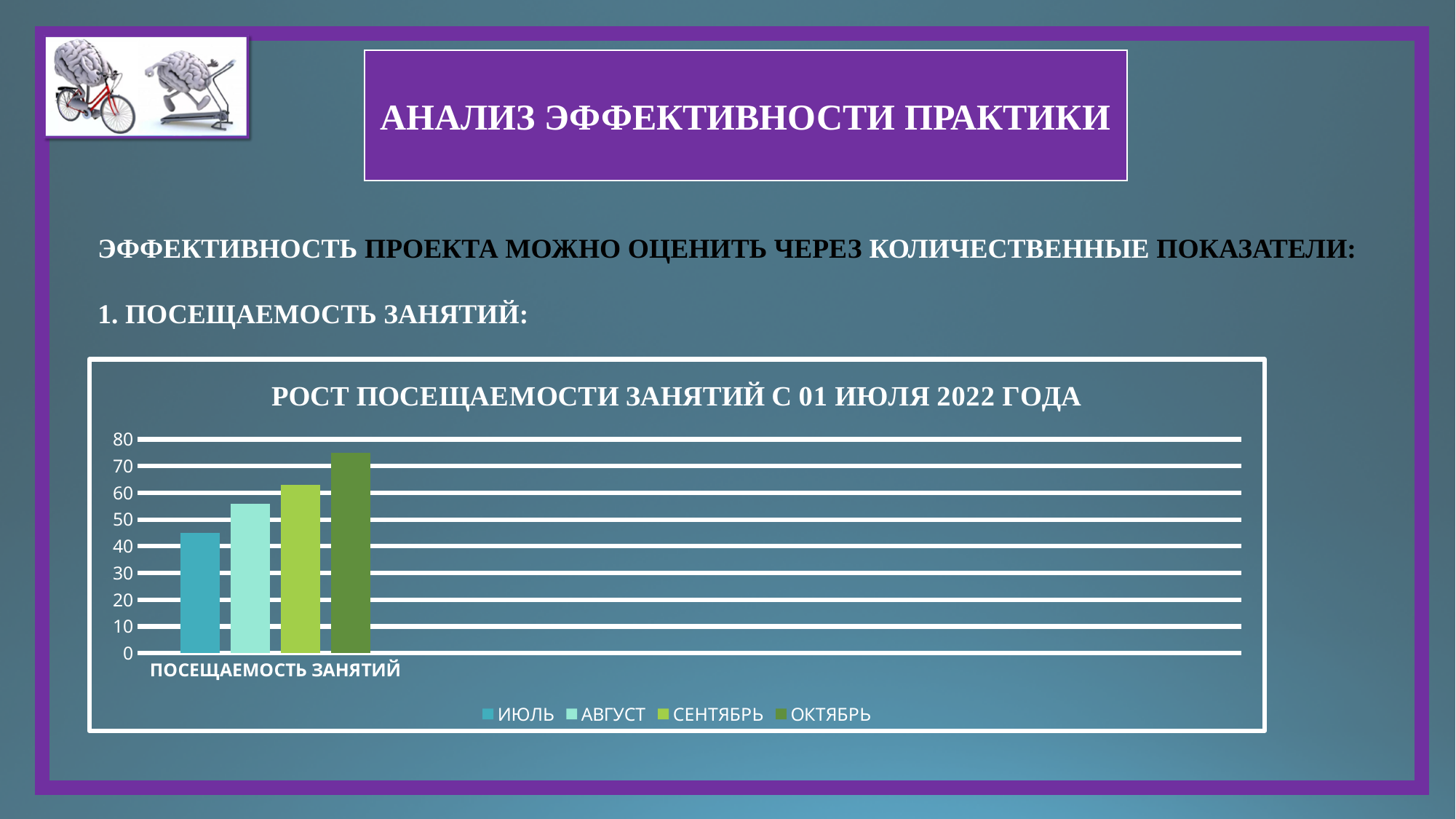
Is the value for АВГУСТ greater or less than 50? greater Is the value for СЕНТЯБРЬ greater or less than 70? less What kind of chart is shown on the slide? bar chart How many series does the legend list? 4 Is the value for ОКТЯБРЬ greater or less than 70? greater How many categories are shown on the x axis? 1 Do the bars rise or fall from ИЮЛЬ to ОКТЯБРЬ? rise Which is larger, the bar for АВГУСТ or the bar for СЕНТЯБРЬ? СЕНТЯБРЬ Which month has the lowest attendance bar? ИЮЛЬ Which month has the highest attendance bar? ОКТЯБРЬ What is the title of the chart? РОСТ ПОСЕЩАЕМОСТИ ЗАНЯТИЙ С 01 ИЮЛЯ 2022 ГОДА